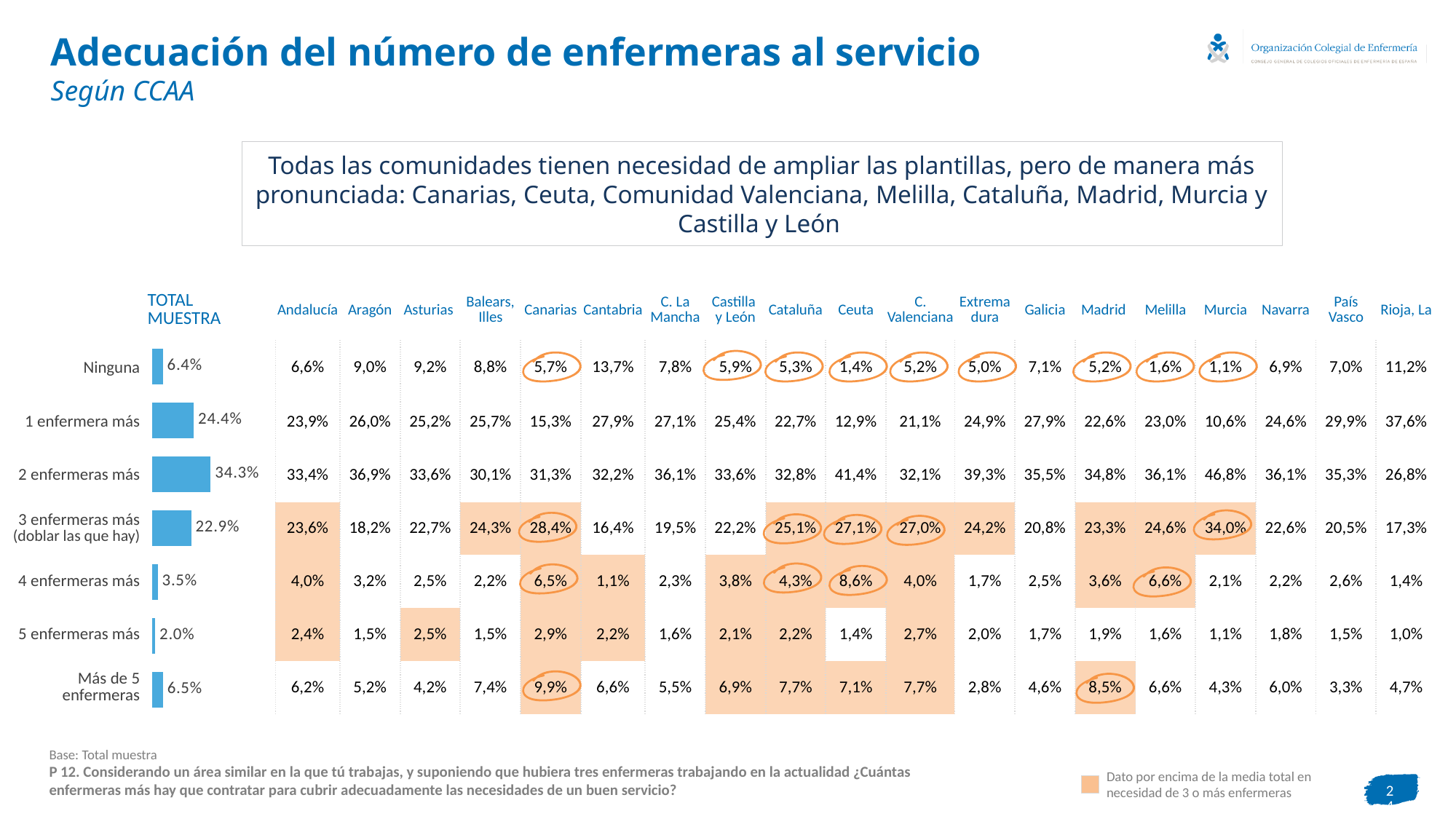
In the TOTAL MUESTRA bar chart, what is the value for 'Ninguna'? 6.4% What kind of chart is used for the TOTAL MUESTRA column? Bar chart In the TOTAL MUESTRA bar chart, what is the value for '1 enfermera más'? 24.4% In the TOTAL MUESTRA bar chart, what is the difference between '2 enfermeras más' and '1 enfermera más'? 9.9% In the TOTAL MUESTRA bar chart, which category has the lowest value? 5 enfermeras más What colour are the bars in the TOTAL MUESTRA chart? Blue How many categories does the TOTAL MUESTRA bar chart show? 7 In the TOTAL MUESTRA bar chart, what is the value for 'Más de 5 enfermeras'? 6.5% In the TOTAL MUESTRA bar chart, which category has the highest value? 2 enfermeras más In the TOTAL MUESTRA bar chart, what is the difference between '3 enfermeras más (doblar las que hay)' and '4 enfermeras más'? 19.4% In the TOTAL MUESTRA bar chart, what is the value for '2 enfermeras más'? 34.3% In the TOTAL MUESTRA bar chart, which is larger: '1 enfermera más' or '3 enfermeras más (doblar las que hay)'? 1 enfermera más